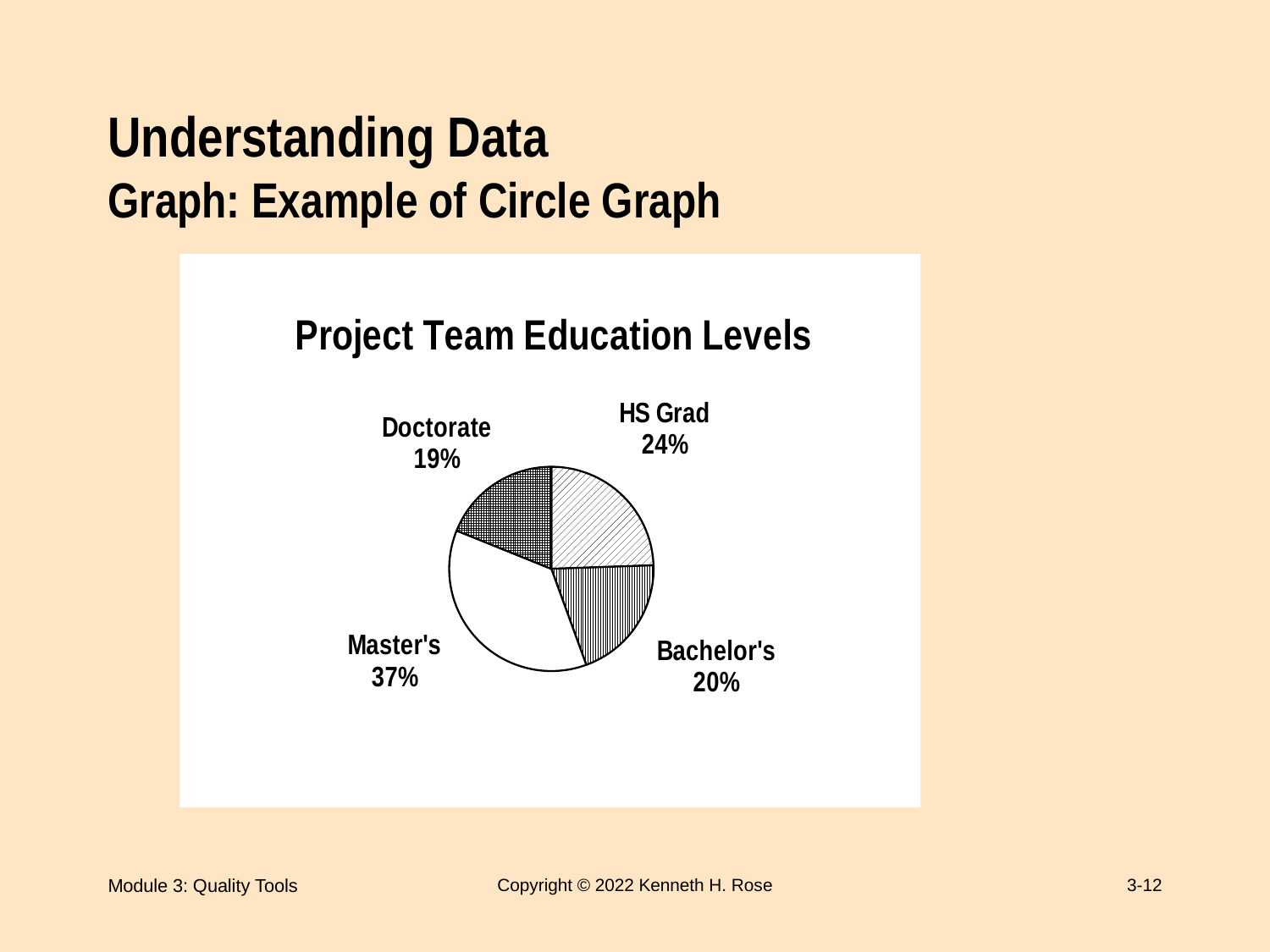
How many categories are shown in the pie chart? 4 Which education level has the largest slice of the pie? Master's What is the difference in percentage points between Bachelor's and Doctorate? 1 What is the value shown for Bachelor's? 20% Which education level has the smallest slice of the pie? Doctorate What is the difference in percentage points between Master's and HS Grad? 13 What share of the pie does Master's represent? 37% Which is larger, the share for HS Grad or the share for Bachelor's? HS Grad What is the value shown for HS Grad? 24% What is the value shown for Doctorate? 19% What kind of chart is shown on the slide? Pie chart What is the title of the chart? Project Team Education Levels